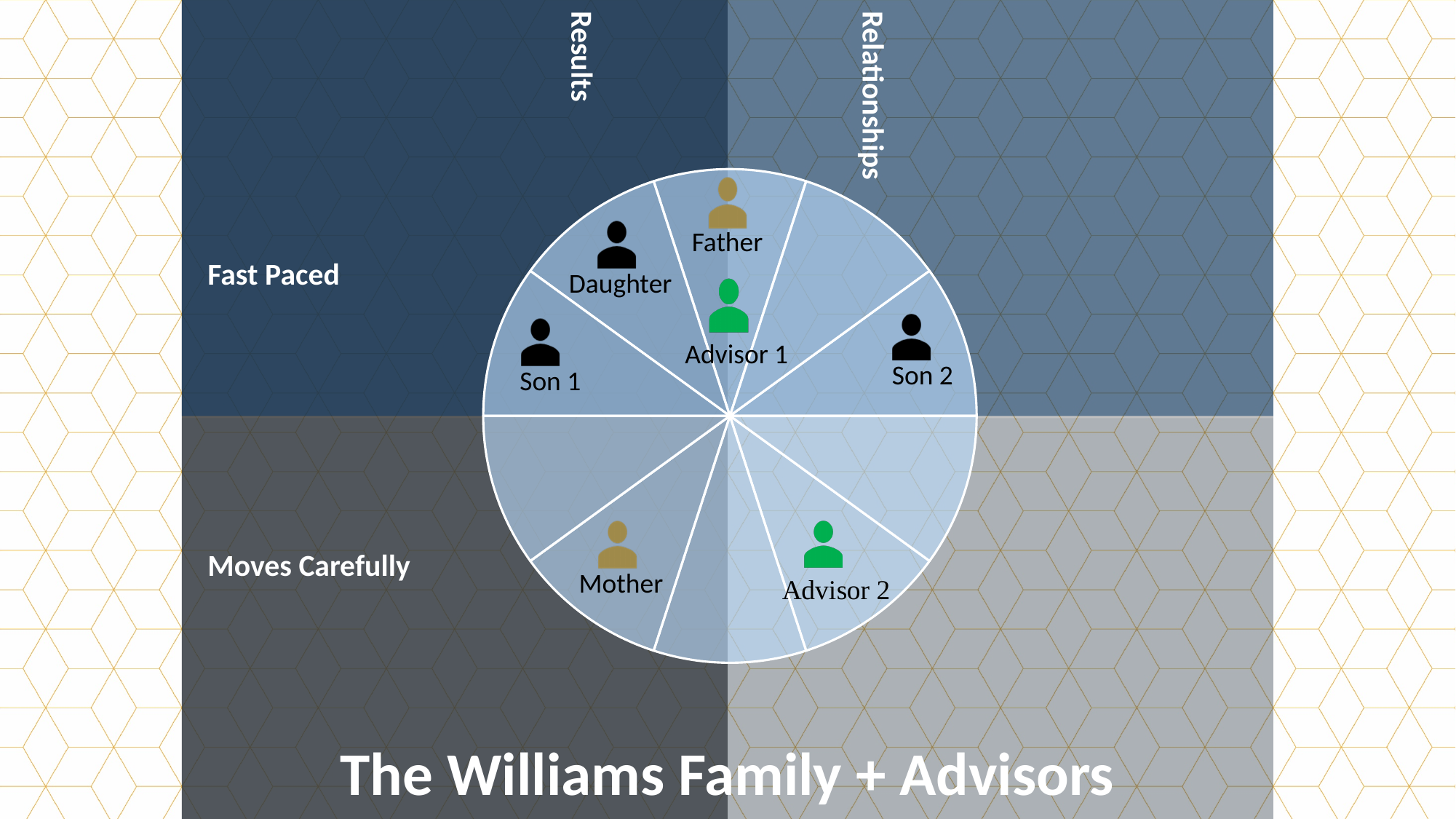
Which family member is placed in the same quadrant as Son 1? Daughter Which quadrant is Son 1 placed in? Fast Paced / Results Which quadrant is Advisor 2 placed in? Moves Carefully / Relationships Which quadrant is Son 2 placed in? Fast Paced / Relationships What kind of chart is shown on the slide? pie chart Which quadrant is Mother placed in? Moves Carefully / Results How many people are labelled on the wheel? 7 Which label appears on the left side of the upper half of the slide? Fast Paced What is the title of the slide? The Williams Family + Advisors How many advisors are shown on the wheel? 2